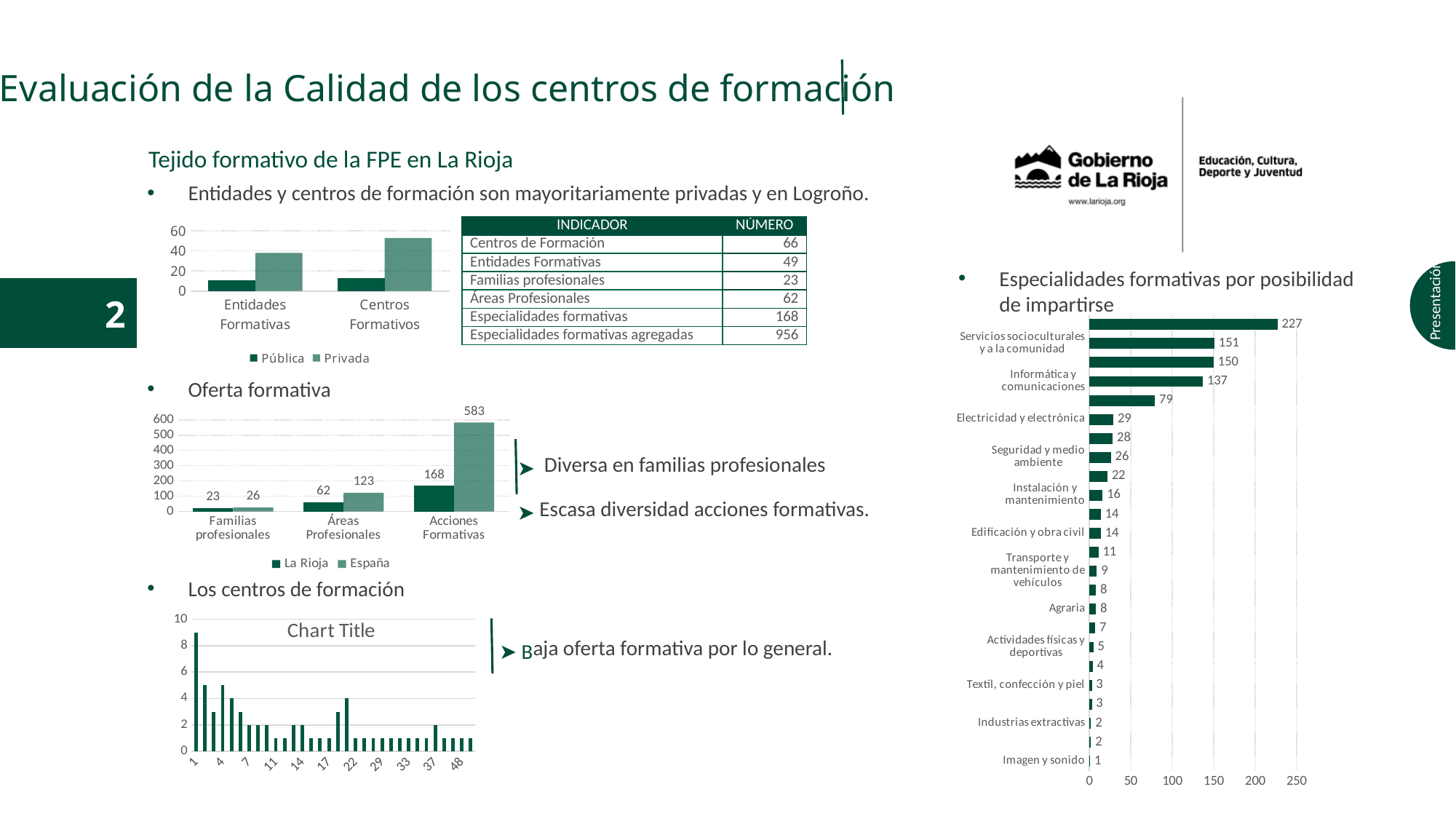
In the 'Especialidades formativas por posibilidad de impartirse' chart, what is the value for Informática y comunicaciones? 137 What kind of chart is the 'Especialidades formativas por posibilidad de impartirse' chart? bar chart In the 'Oferta formativa' chart, what is the value for La Rioja in Áreas Profesionales? 62 In the 'Oferta formativa' chart, which category has the highest value for La Rioja? Acciones Formativas In the 'Especialidades formativas por posibilidad de impartirse' chart, which is larger: Seguridad y medio ambiente or Instalación y mantenimiento? Seguridad y medio ambiente In the 'Especialidades formativas por posibilidad de impartirse' chart, what is the value for Electricidad y electrónica? 29 How many series does the legend of the 'Oferta formativa' chart list? 2 In the 'Especialidades formativas por posibilidad de impartirse' chart, which labelled category has the lowest value? Imagen y sonido In the 'Oferta formativa' chart, what is the difference between España and La Rioja for Familias profesionales? 3 In the 'Oferta formativa' chart, what is the value for España in Acciones Formativas? 583 In the top-left chart with the Pública/Privada legend, is the Pública value for Entidades Formativas greater or less than 20? less In the top-left chart with the Pública/Privada legend, is the Privada value for Centros Formativos greater or less than 40? greater